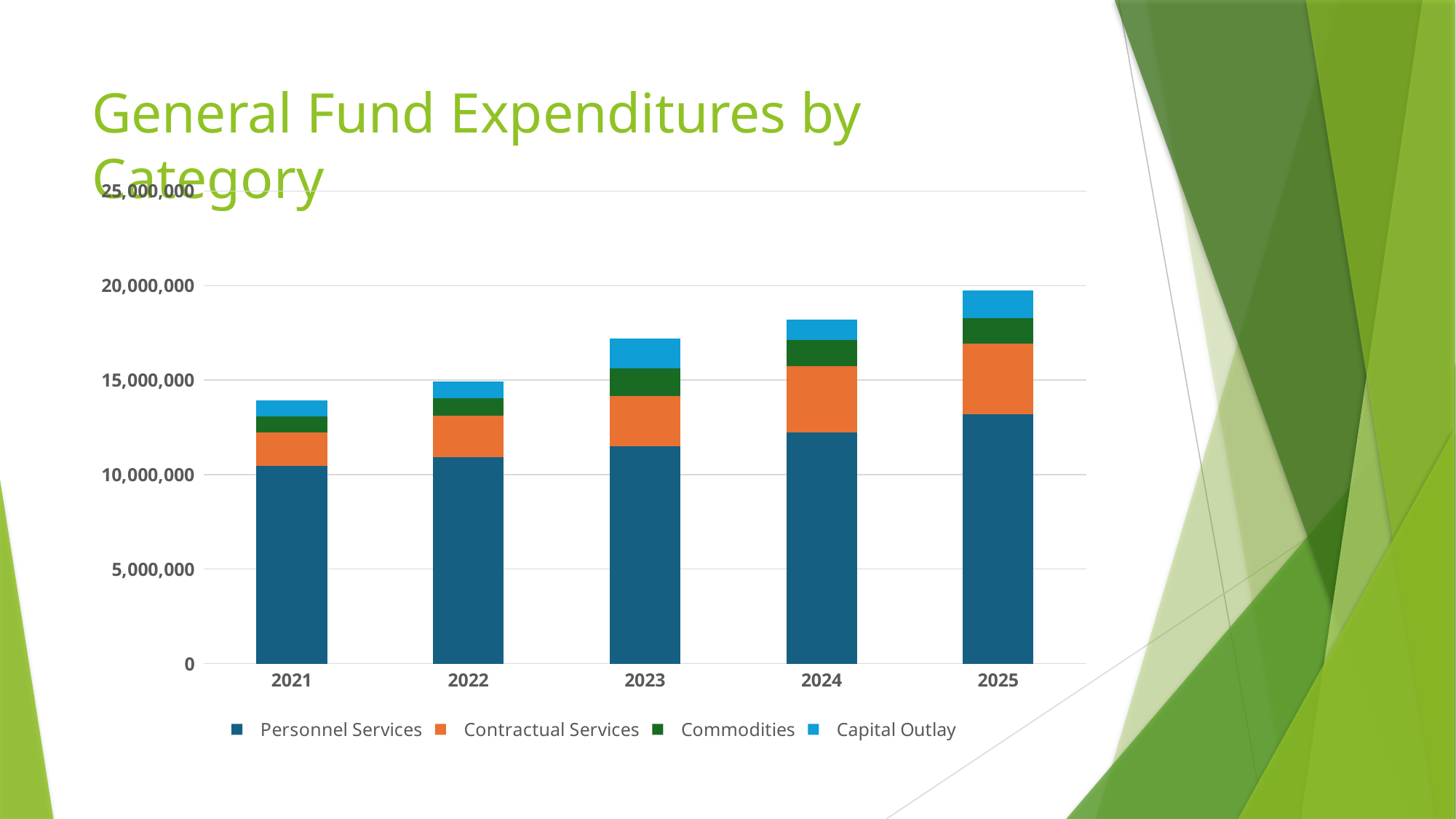
Which year has the lowest total General Fund expenditures? 2021 How many years are shown on the x axis of the chart? 5 Which year has the highest total General Fund expenditures? 2025 What kind of chart is shown on the slide? Stacked bar chart Is the total expenditure for 2023 greater or less than 15,000,000? greater Is the total expenditure for 2021 greater or less than 15,000,000? less Which is larger, the total expenditure for 2022 or for 2024? 2024 Do total expenditures rise or fall from 2021 to 2025? Rise Which series is shown in orange in the chart's legend? Contractual Services How many series does the chart's legend list? 4 Is the Personnel Services value for 2021 greater or less than 10,000,000? greater